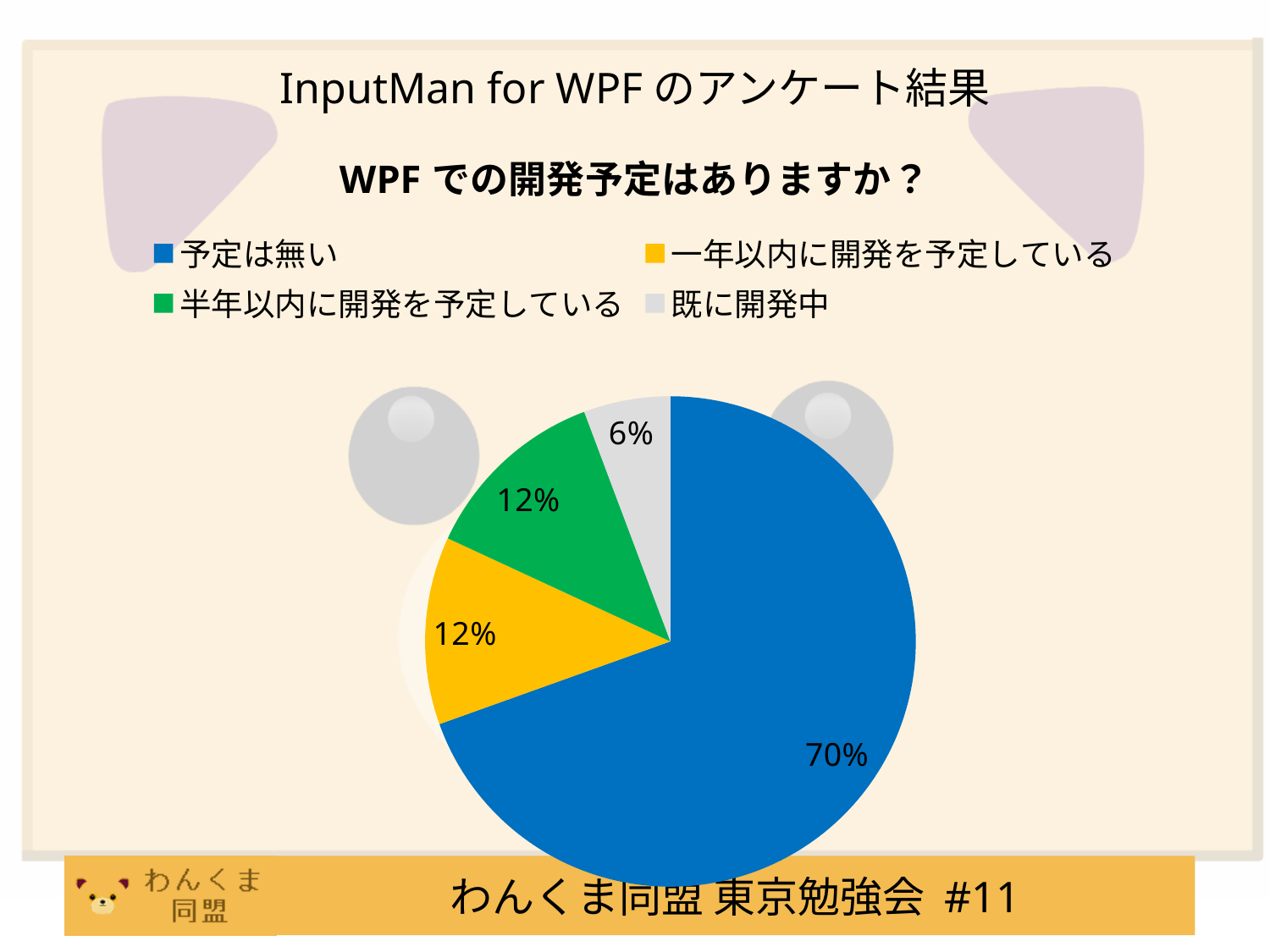
Which category has the smallest slice? 既に開発中 What share of the pie is 半年以内に開発を予定している? 12% Which colour represents 既に開発中 in the legend? gray What kind of chart is shown on the slide? pie chart Which category has the largest slice? 予定は無い How many slices does the pie chart have? 4 What share of the pie is 予定は無い? 70% What is the chart's title? WPF での開発予定はありますか？ What share of the pie is 既に開発中? 6% What is the difference between the shares of 予定は無い and 既に開発中? 64% How many entries does the legend list? 4